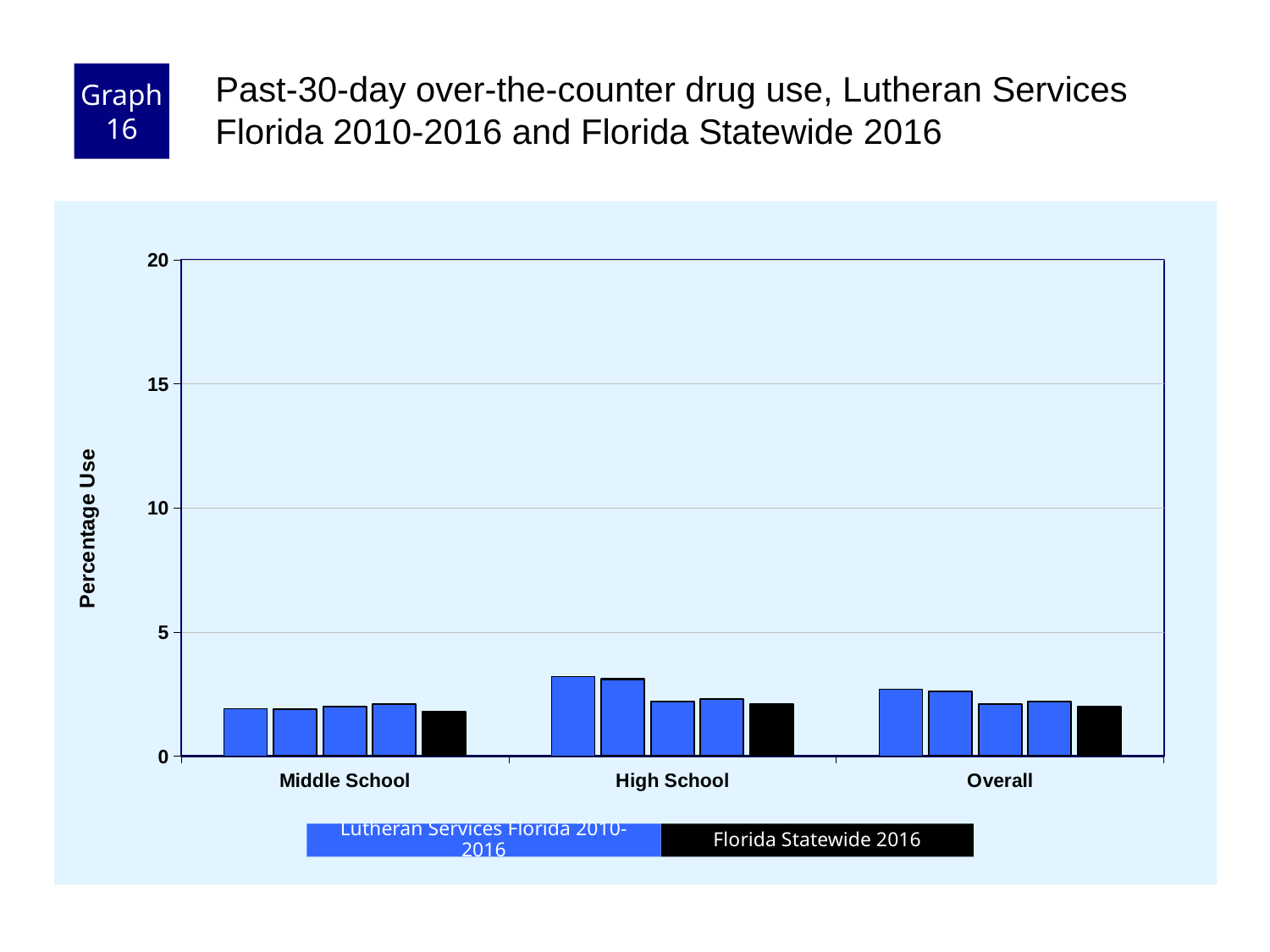
Is the tallest Lutheran Services Florida bar for High School greater or less than 5? less Is the Florida Statewide 2016 value for Overall greater or less than 10? less How many categories are shown along the x axis? 3 Are any of the bars on the chart greater than 5? No Which series is shown in black in the legend? Florida Statewide 2016 How many series does the legend list? 2 Which is larger: the first Lutheran Services Florida bar for High School or the first Lutheran Services Florida bar for Middle School? High School Which category contains the tallest bar on the chart? High School What is the label on the y axis? Percentage Use What kind of chart is shown on the slide? bar chart